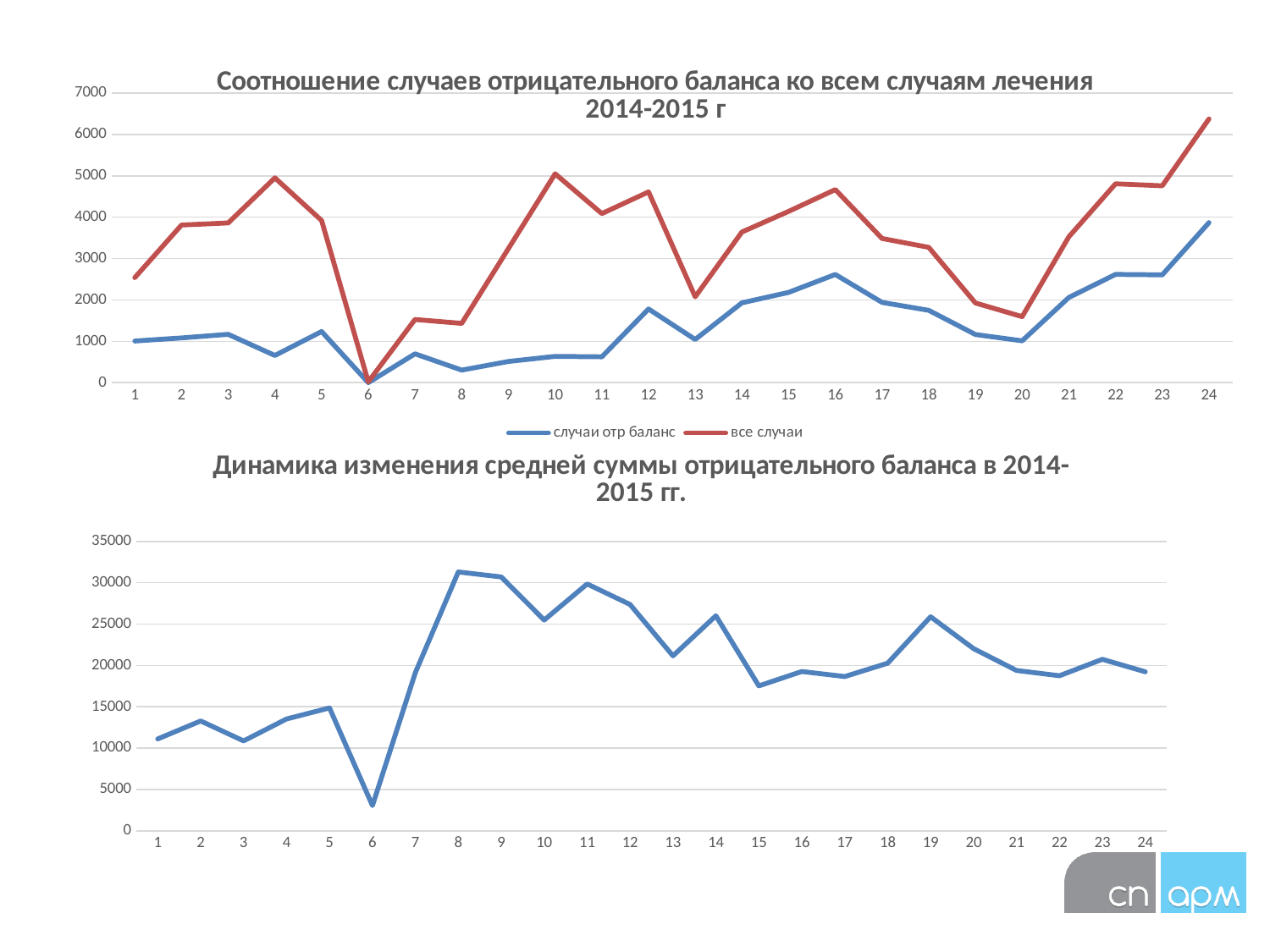
How many series does the legend of the top chart list? 2 What type of chart is the top chart titled "Соотношение случаев отрицательного баланса ко всем случаям лечения 2014-2015 г"? line chart In the top chart, at which x-axis point does the "все случаи" series reach its highest value? 24 In the bottom chart, at which x-axis point is the value highest? 8 In the top chart, which colour is used for the "случаи отр баланс" series? blue In the top chart, at point 12, which series has the larger value: "случаи отр баланс" or "все случаи"? все случаи In the top chart, is the value of "все случаи" at point 24 greater or less than 6000? greater In the top chart, at which x-axis point does the "все случаи" series reach its lowest value? 6 In the top chart, is the value of "случаи отр баланс" at point 16 greater or less than 2000? greater In the bottom chart, at which x-axis point is the value lowest? 6 How many points are plotted along the x axis of the bottom chart "Динамика изменения средней суммы отрицательного баланса в 2014-2015 гг."? 24 In the bottom chart, is the value at point 15 greater or less than 20000? less